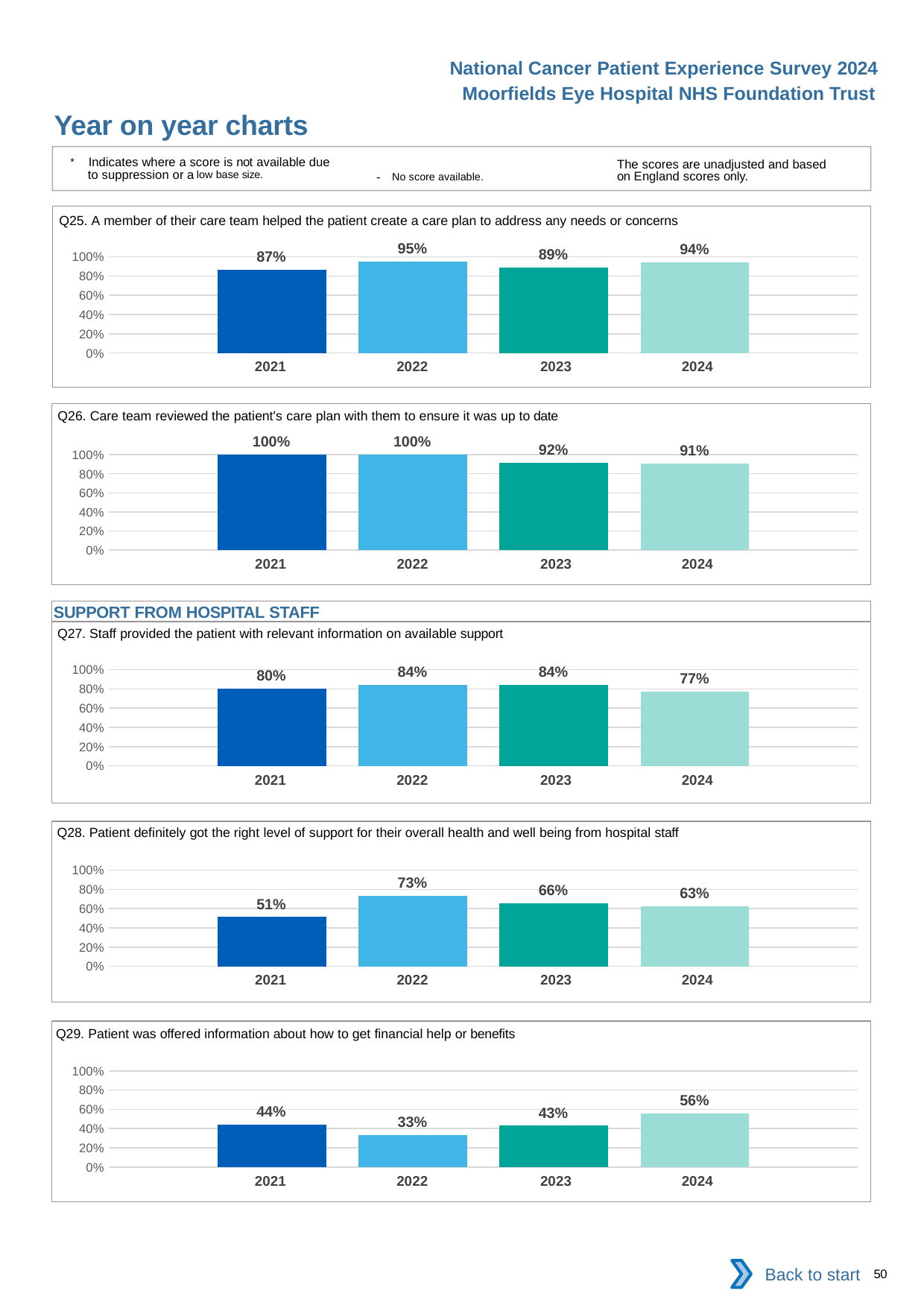
In the Q29 chart, which is larger, the value for 2021 or the value for 2024? 2024 In the Q27 chart, what is the difference between the 2023 value and the 2024 value? 7% What kind of chart is the Q26 chart? bar chart In the Q25 chart, what is the value for 2022? 95% How many years are shown in the Q25 chart? 4 In the Q29 chart, what is the value for 2022? 33% In the Q28 chart, which year has the highest value? 2022 In the Q28 chart, do the values rise or fall from 2022 to 2024? fall What is the section heading shown above the Q27 chart? SUPPORT FROM HOSPITAL STAFF In the Q26 chart, what is the difference between the 2021 value and the 2023 value? 8% In the Q26 chart, which year has the lowest value? 2024 In the Q28 chart, is the value for 2021 greater or less than 60%? less